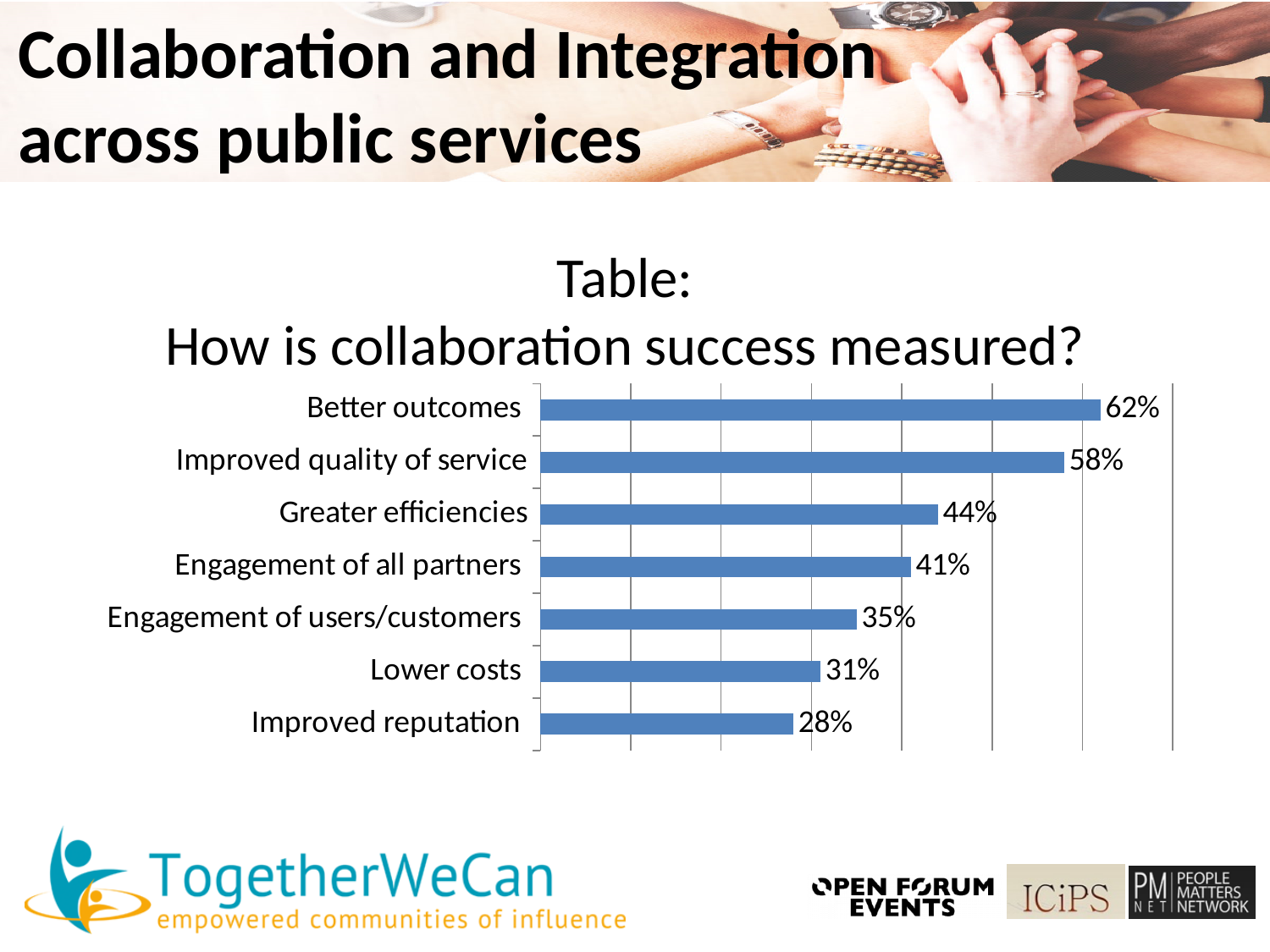
Which category has the lowest value? Improved reputation What percentage is shown for Better outcomes? 62% Which is larger, the value for Lower costs or the value for Engagement of users/customers? Engagement of users/customers Which category has the highest value? Better outcomes What percentage is shown for Improved reputation? 28% What percentage is shown for Engagement of users/customers? 35% What percentage is shown for Improved quality of service? 58% What is the difference between the values for Greater efficiencies and Engagement of all partners? 3% How many categories are shown in the chart? 7 What is the title of the chart? Table: How is collaboration success measured? What is the difference between the values for Better outcomes and Improved reputation? 34% What kind of chart is shown on the slide? Bar chart